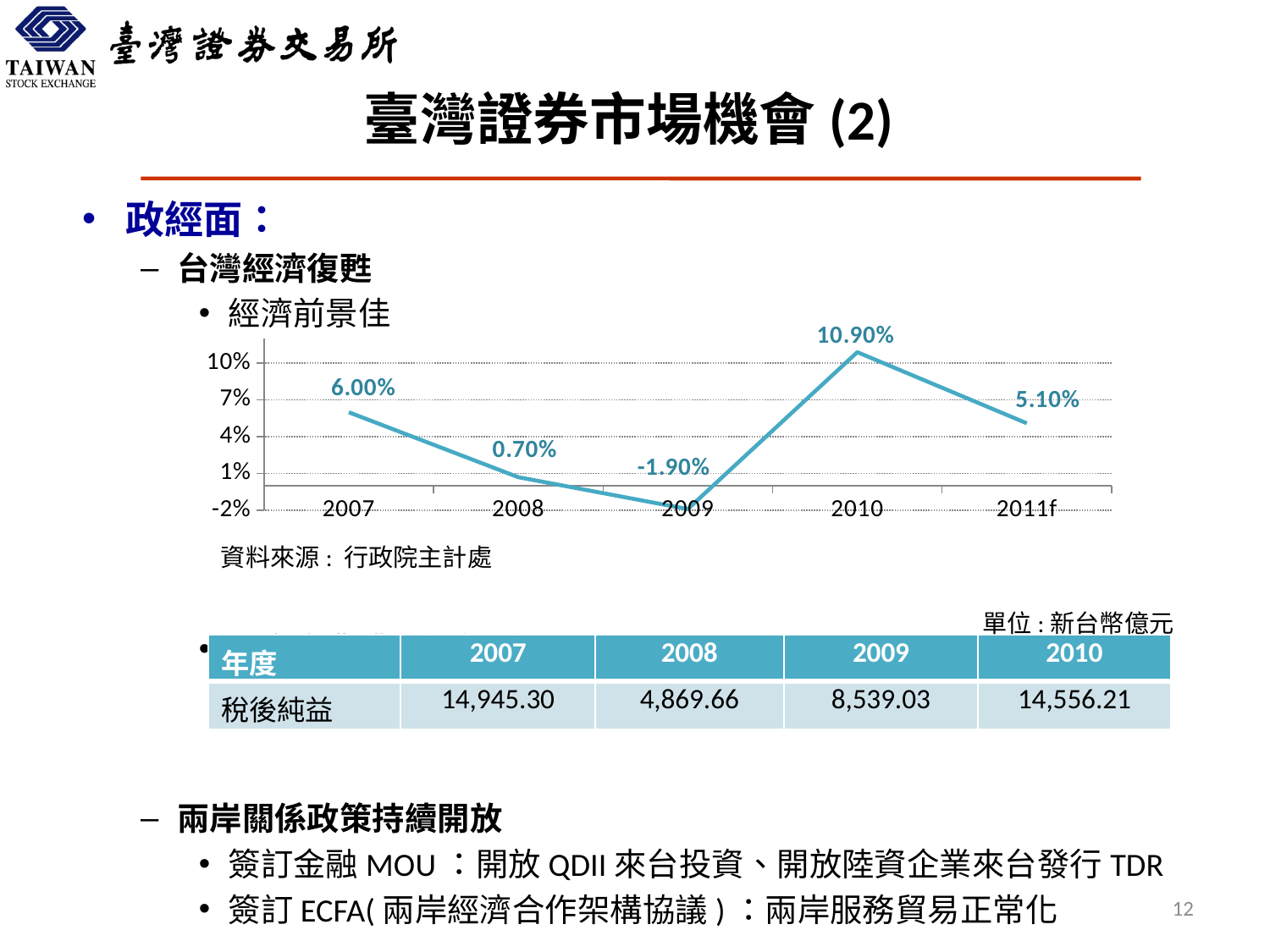
What is the difference between the values for 2010 and 2011f on the line chart? 5.80% Which is larger on the line chart, the value for 2007 or the value for 2008? 2007 What is the value for 2007 on the line chart? 6.00% What kind of chart is shown on the slide? line chart Which year has the highest value on the line chart? 2010 Which year has the lowest value on the line chart? 2009 Is the value for 2010 on the line chart greater or less than 10%? greater How many years are plotted on the line chart? 5 What is the value for 2010 on the line chart? 10.90% Does the line rise or fall from 2007 to 2009 on the line chart? fall What is the value for 2011f on the line chart? 5.10% What is the value for 2009 on the line chart? -1.90%